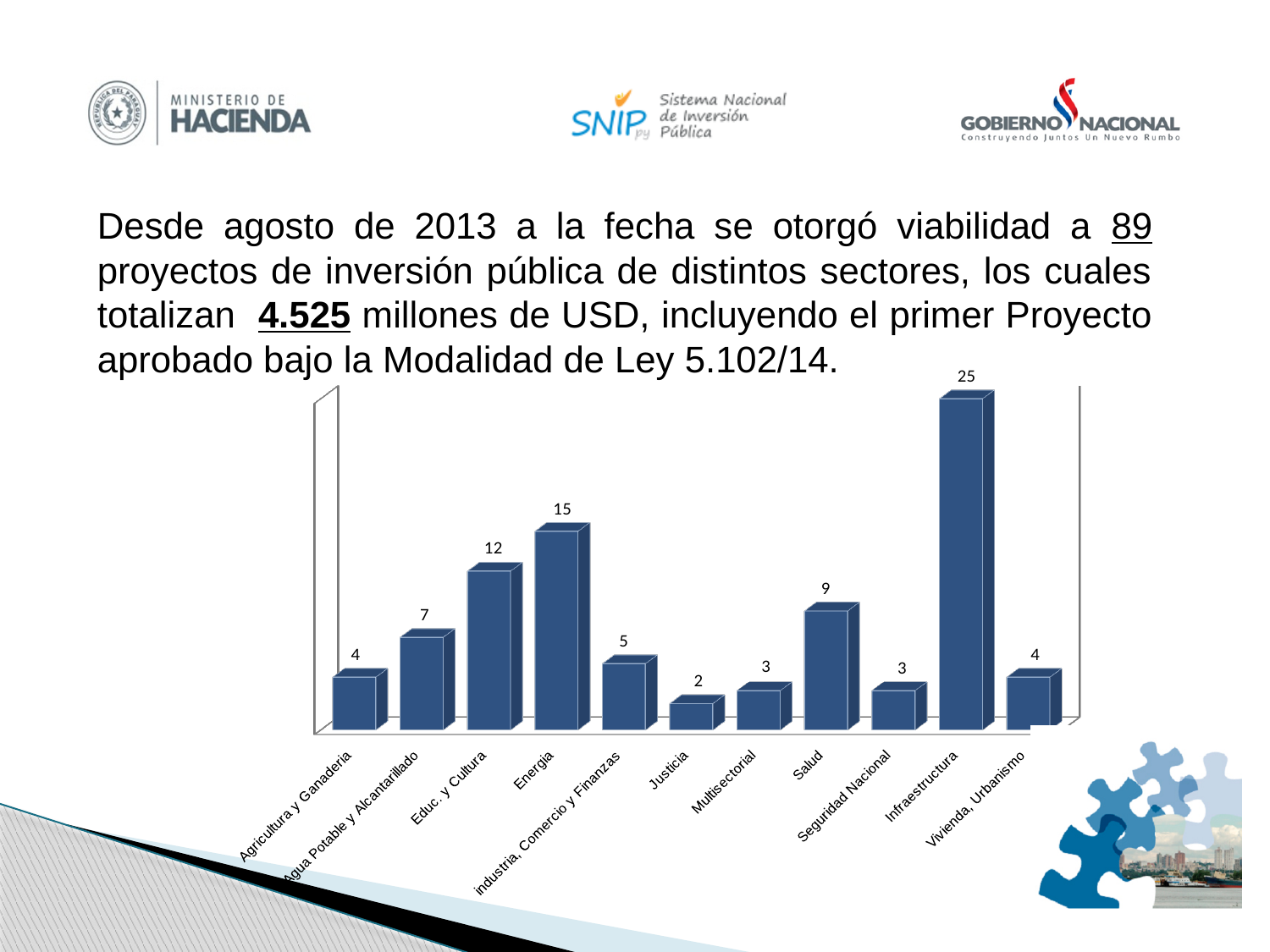
What value is shown for Infraestructura? 25 Which is larger, the value for Salud or the value for Industria, Comercio y Finanzas? Salud What value is shown for Salud? 9 What is the difference between the values for Educ. y Cultura and Agua Potable y Alcantarillado? 5 How many categories are shown on the x axis? 11 Which category has the lowest value? Justicia What kind of chart is shown on the slide? Bar chart What is the difference between the values for Infraestructura and Energía? 10 What value is shown for Energía? 15 Which two categories both have a value of 3? Multisectorial and Seguridad Nacional Which category has the highest value? Infraestructura What value is shown for Justicia? 2